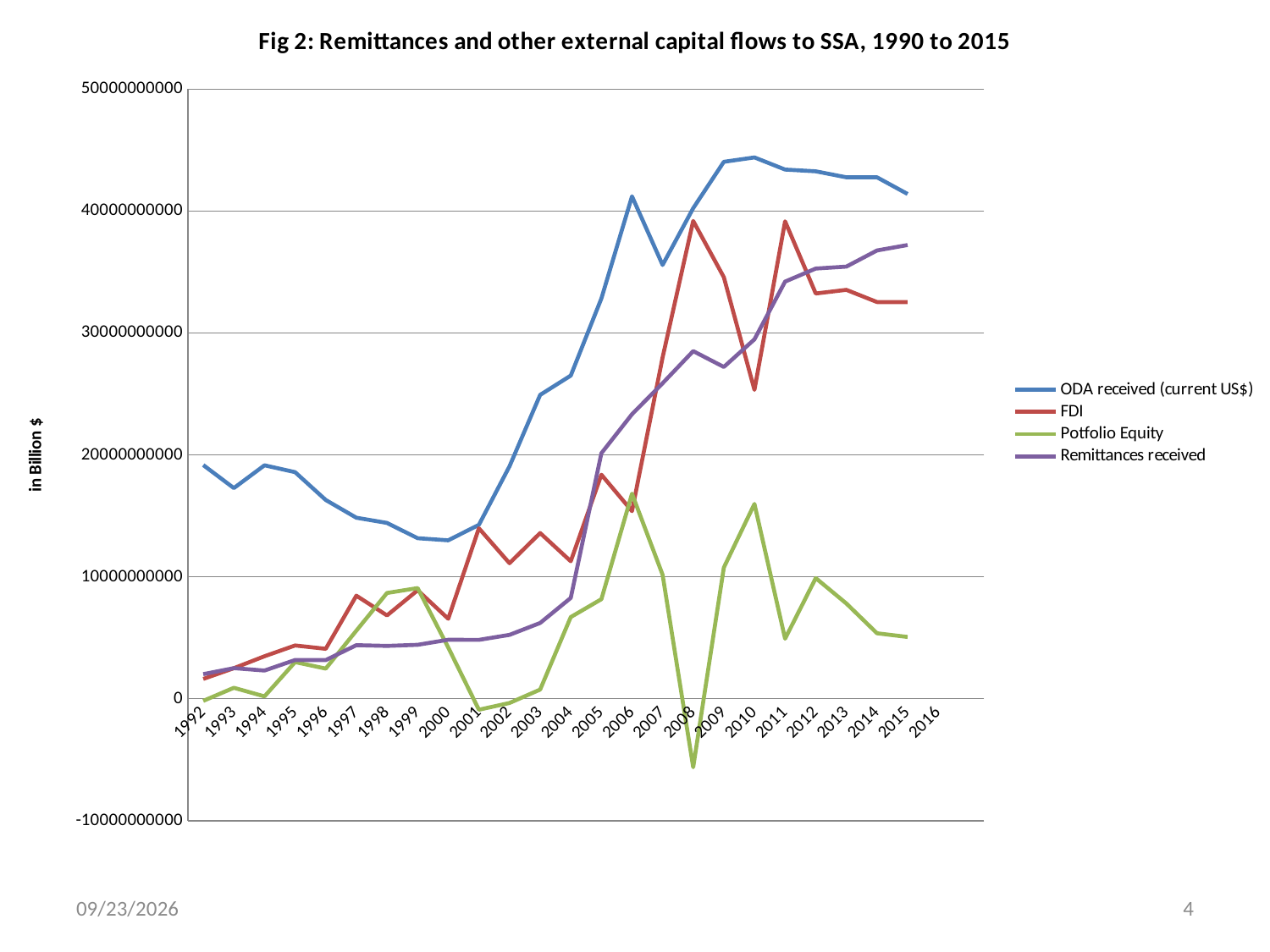
What kind of chart is shown on the slide? line chart Is the value for Remittances received in 2015 greater or less than 30000000000? greater Is the value for Potfolio Equity in 2008 greater or less than 0? less Which series has the lowest value in 2015? Potfolio Equity What is the title of the chart? Fig 2: Remittances and other external capital flows to SSA, 1990 to 2015 In 2006, which is larger: ODA received or FDI? ODA received (current US$) How many series does the legend list? 4 Which series reaches the lowest value anywhere on the chart? Potfolio Equity Which series has the highest value in 2015? ODA received (current US$) Does the Remittances received line generally rise or fall from 2000 to 2015? rise What is the label on the vertical axis? in Billion $ Is the value for ODA received in 2010 greater or less than 40000000000? greater